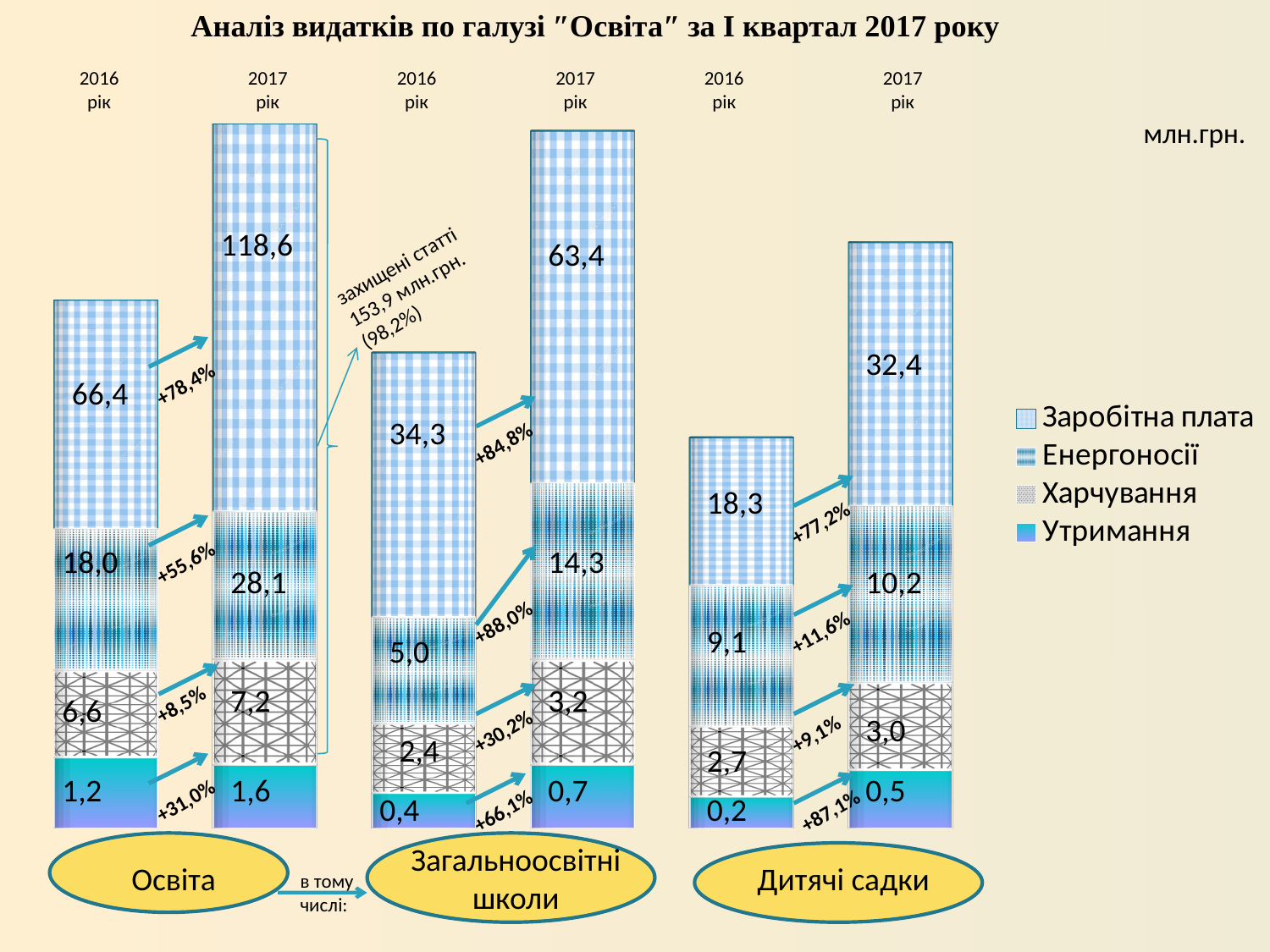
What is the difference between Заробітна плата for Загальноосвітні школи in 2017 and in 2016? 29,1 Which series has the highest value in the Дитячі садки 2017 bar? Заробітна плата How many series does the legend list? 4 What is the total of the stacked bar for Дитячі садки in 2016? 30,3 What percentage change is shown for Утримання for Дитячі садки from 2016 to 2017? +87,1% What is the value of Заробітна плата for Освіта in 2017? 118,6 What type of chart is shown on the slide? Stacked bar chart Which series has the lowest value in the Освіта 2016 bar? Утримання What is the value of Енергоносії for Дитячі садки in 2016? 9,1 What is the value of Утримання for Загальноосвітні школи in 2017? 0,7 Which is larger: Харчування for Освіта in 2017 or Харчування for Загальноосвітні школи in 2017? Освіта 2017 (7,2) What is the total of the stacked bar for Освіта in 2017? 155,5